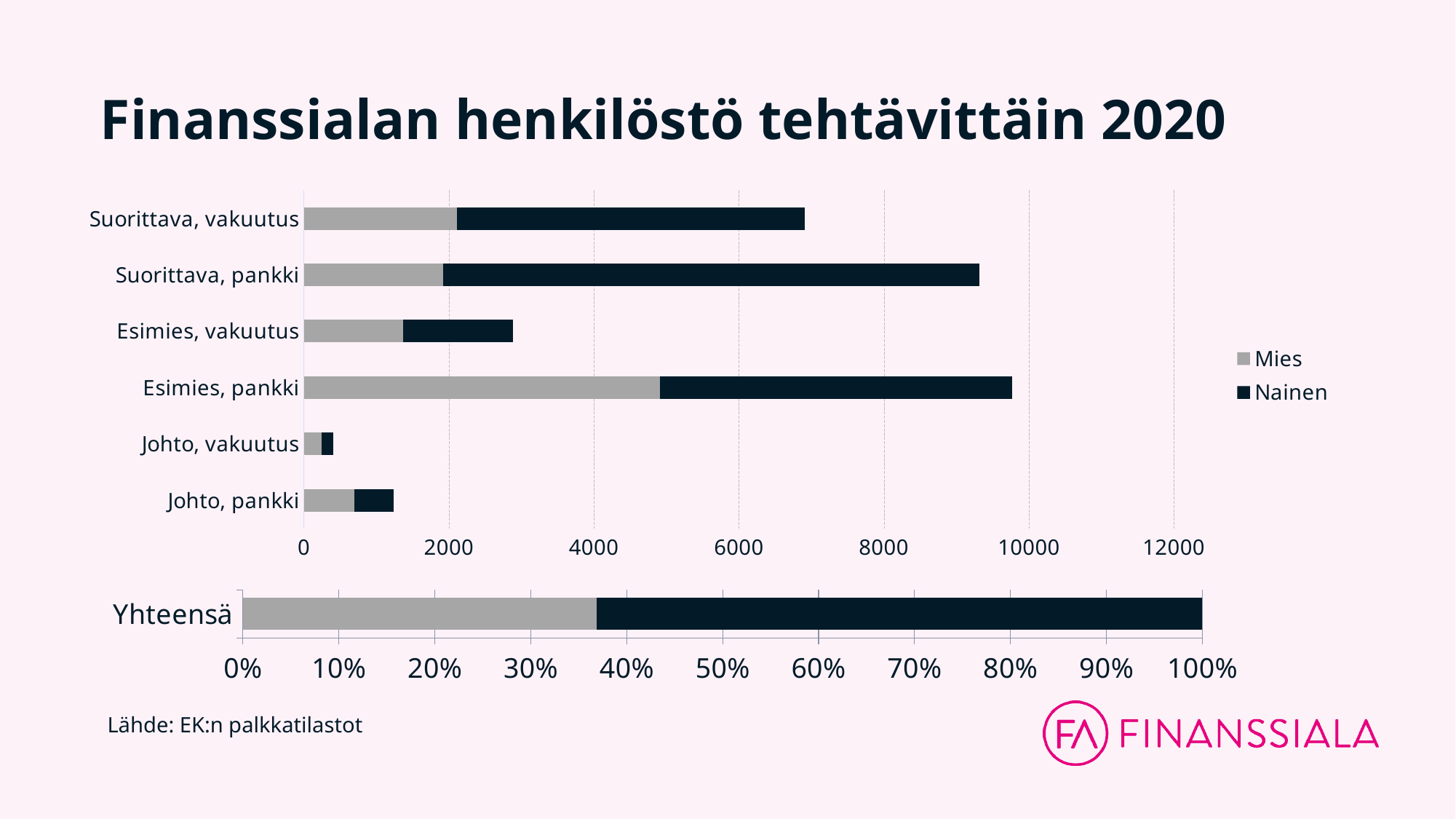
In the upper chart, is the total bar for Suorittava, pankki greater or less than 8000? greater In the upper chart, which category has the largest Mies segment? Esimies, pankki How many categories does the upper chart show? 6 In the upper chart, is the total bar for Esimies, vakuutus greater or less than 4000? less In the lower Yhteensä chart, is the Mies share greater or less than 40%? less What are the two series named in the legend? Mies and Nainen In the upper chart, which category has the smallest total bar? Johto, vakuutus In the upper chart, which has the larger total bar: Suorittava, vakuutus or Esimies, vakuutus? Suorittava, vakuutus How many series does the legend list? 2 What is the title of the slide's chart? Finanssialan henkilöstö tehtävittäin 2020 What kind of chart is the upper chart on the slide? Bar chart